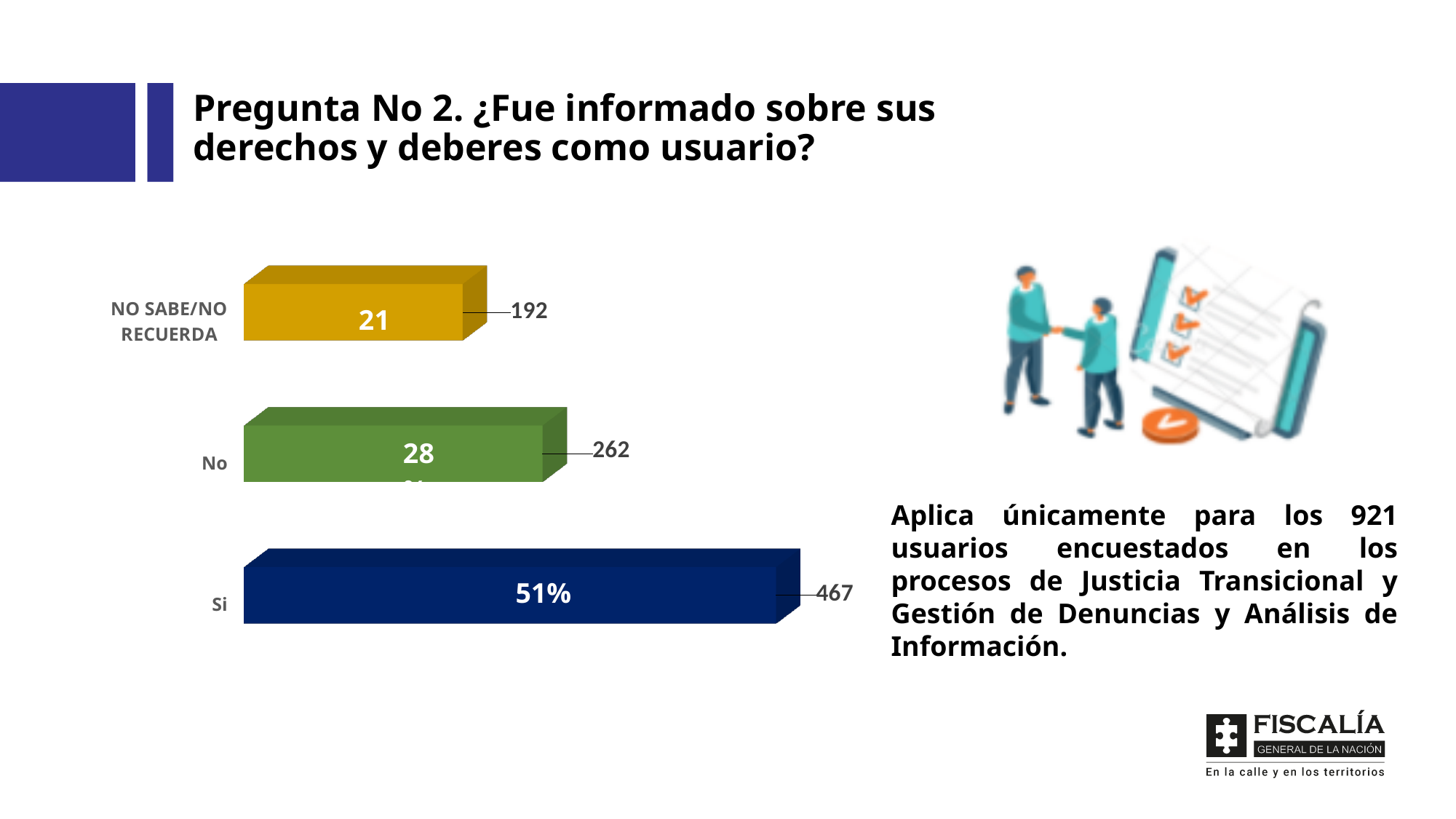
What is the difference between the counts for 'No' and 'NO SABE/NO RECUERDA'? 70 Which is larger, the count for 'No' or the count for 'NO SABE/NO RECUERDA'? No What kind of chart is shown on the slide? bar chart What is the count shown for the 'No' category? 262 What percentage is printed inside the 'Si' bar? 51% What is the count shown for the 'NO SABE/NO RECUERDA' category? 192 What is the difference between the counts for 'Si' and 'No'? 205 Which category has the highest value? Si What colour is the bar for the 'Si' category? dark blue How many categories does the chart show? 3 What is the count shown for the 'Si' category? 467 Which category has the lowest value? NO SABE/NO RECUERDA